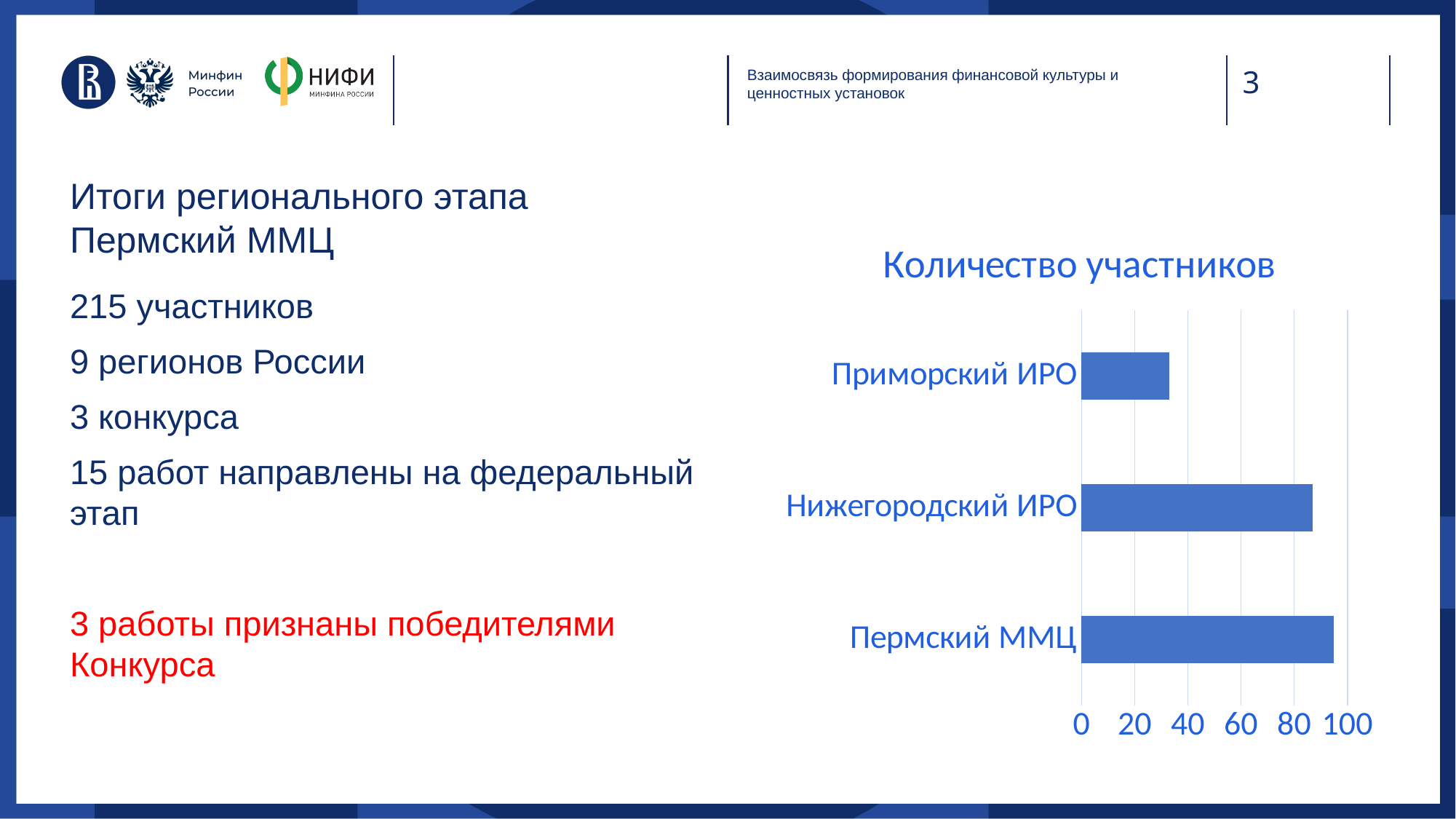
What is the highest value shown on the horizontal axis of the chart? 100 Is the value for Пермский ММЦ greater or less than 100? less Is the value for Приморский ИРО greater or less than 20? greater Is the value for Нижегородский ИРО greater or less than 60? greater Which category has the highest value in the chart? Пермский ММЦ What is the title of the chart? Количество участников How many categories are plotted in the chart? 3 Which is larger, the value for Нижегородский ИРО or the value for Приморский ИРО? Нижегородский ИРО What kind of chart is shown on the slide? bar chart Which category has the lowest value in the chart? Приморский ИРО